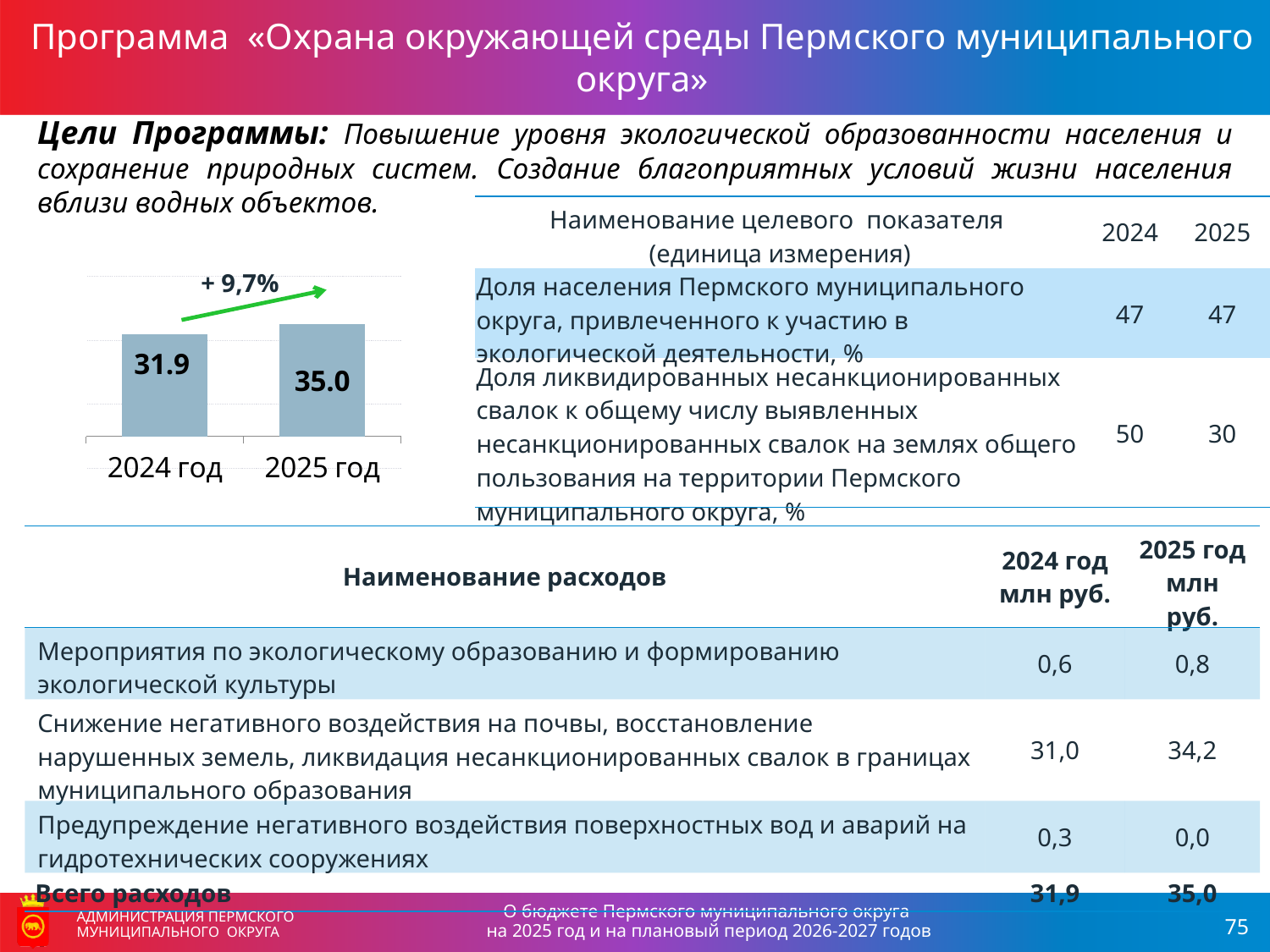
What colour is the arrow drawn above the bars in the chart? green What kind of chart is shown on the slide? bar chart What percentage change is annotated above the bars in the chart? + 9,7% What is the value for 2024 год in the bar chart? 31.9 Which year has the lower bar in the chart? 2024 год What is the difference between the 2025 год and 2024 год values in the bar chart? 3.1 How many bars are shown in the chart? 2 Is the value for 2025 год larger or smaller than the value for 2024 год in the chart? larger Which year has the higher bar in the chart? 2025 год What is the value for 2025 год in the bar chart? 35.0 Do the values in the chart rise or fall from 2024 год to 2025 год? rise